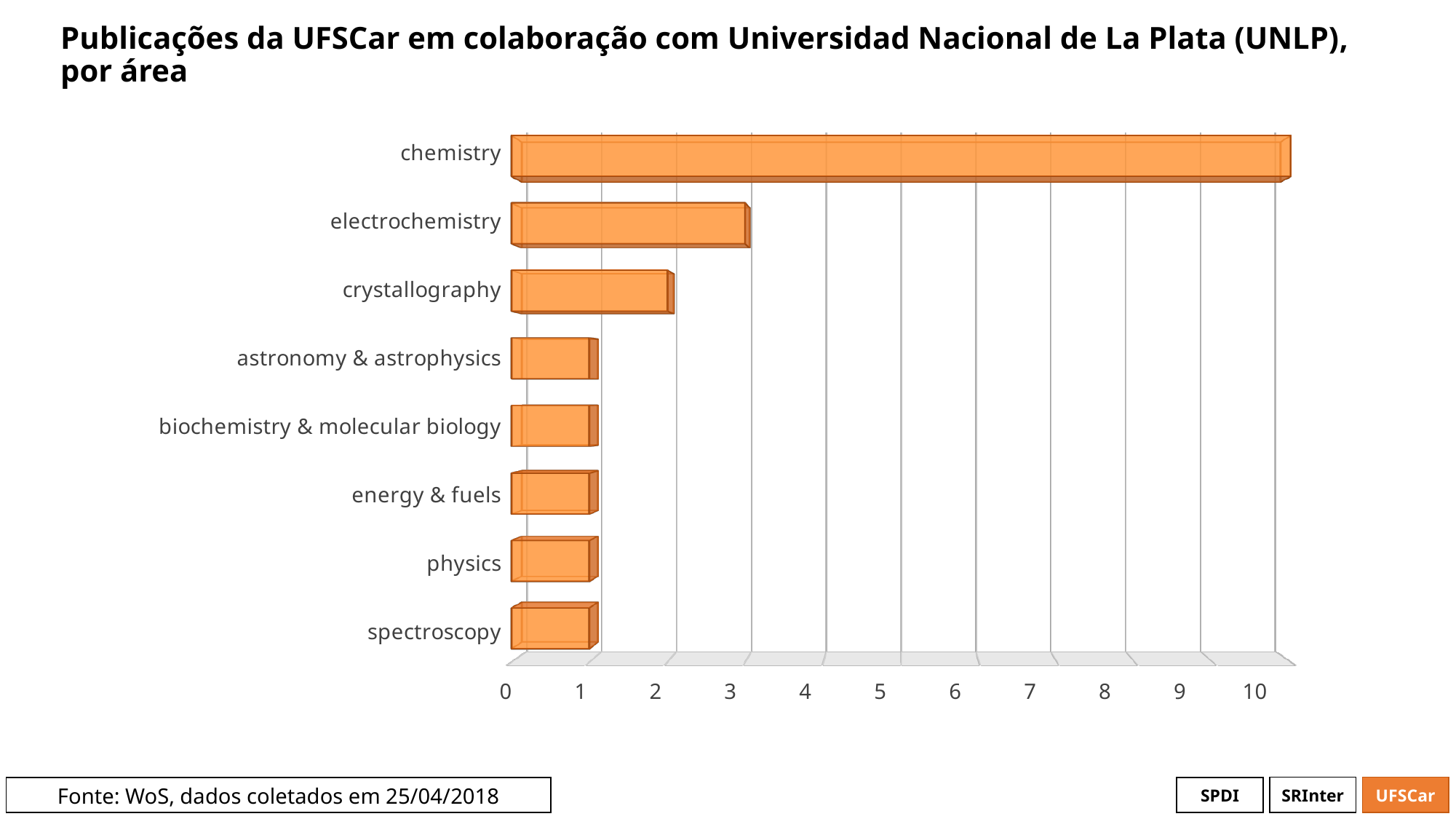
How many publications are shown for spectroscopy? 1 Which area has the highest number of publications? chemistry Is the value for chemistry greater or less than 5? greater Which has more publications, electrochemistry or crystallography? electrochemistry How many publications are shown for crystallography? 2 What is the difference between the number of publications for chemistry and for electrochemistry? 7 How many publications are shown for electrochemistry? 3 Is the value for physics greater or less than 2? less How many areas (categories) are shown in the chart? 8 How many publications are shown for chemistry? 10 What kind of chart is shown on the slide? bar chart What is the data source cited at the bottom of the slide? WoS, dados coletados em 25/04/2018